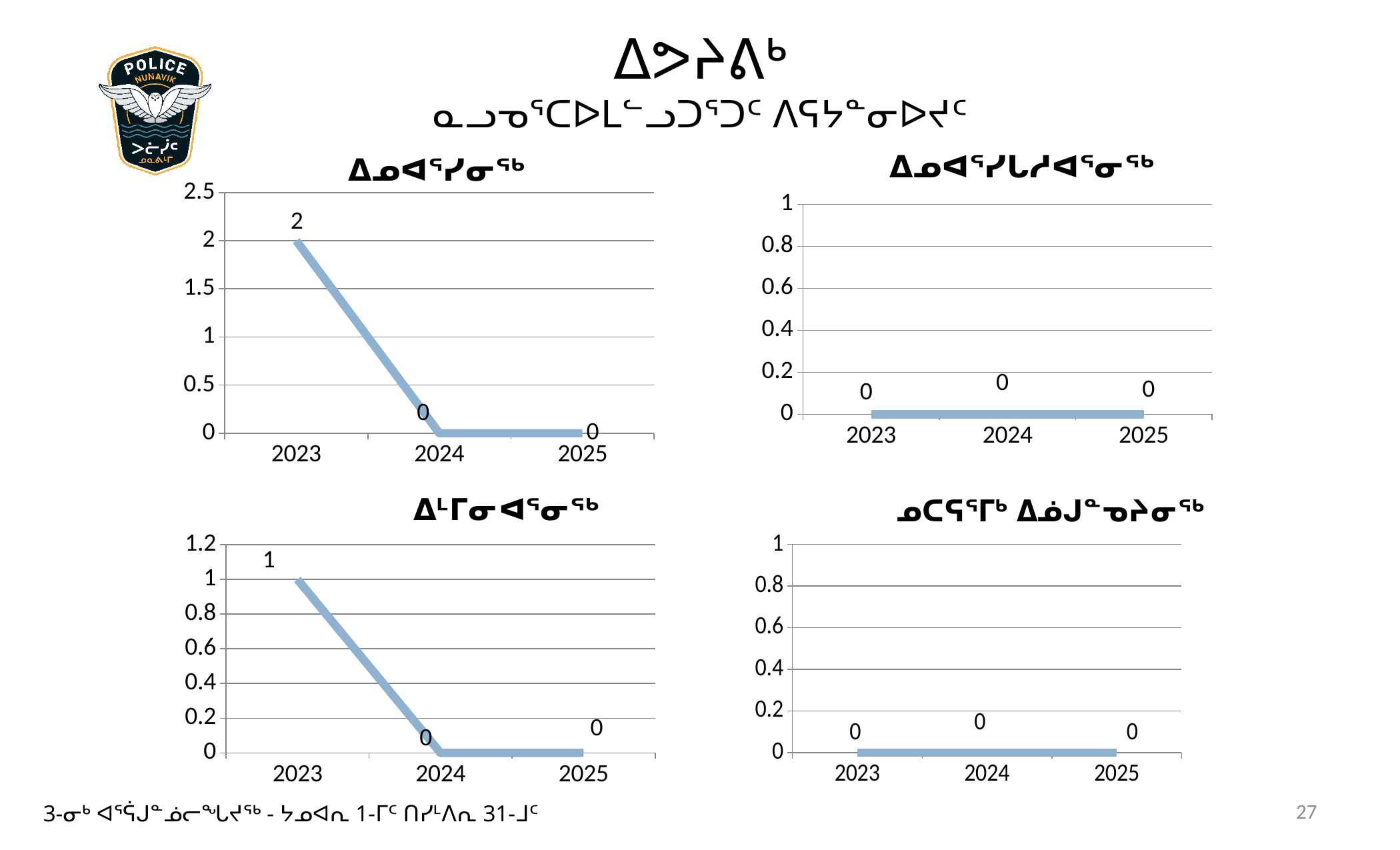
In the top-right chart, what is the value for 2024? 0 In the bottom-left chart, what is the value for 2023? 1 In the top-left chart, which year has the highest value? 2023 How many years are plotted on the x axis of the bottom-right chart? 3 In the bottom-left chart, which year has the highest value? 2023 In the top-left chart, what is the value for 2023? 2 In the top-left chart, what is the value for 2024? 0 Which is larger: the 2023 value in the top-left chart or the 2023 value in the bottom-left chart? The top-left chart (2) In the bottom-left chart, what is the value for 2025? 0 In the bottom-left chart, do the values rise or fall from 2023 to 2025? Fall What kind of chart is the top-left chart? Line chart In the top-left chart, what is the difference between the values for 2023 and 2024? 2